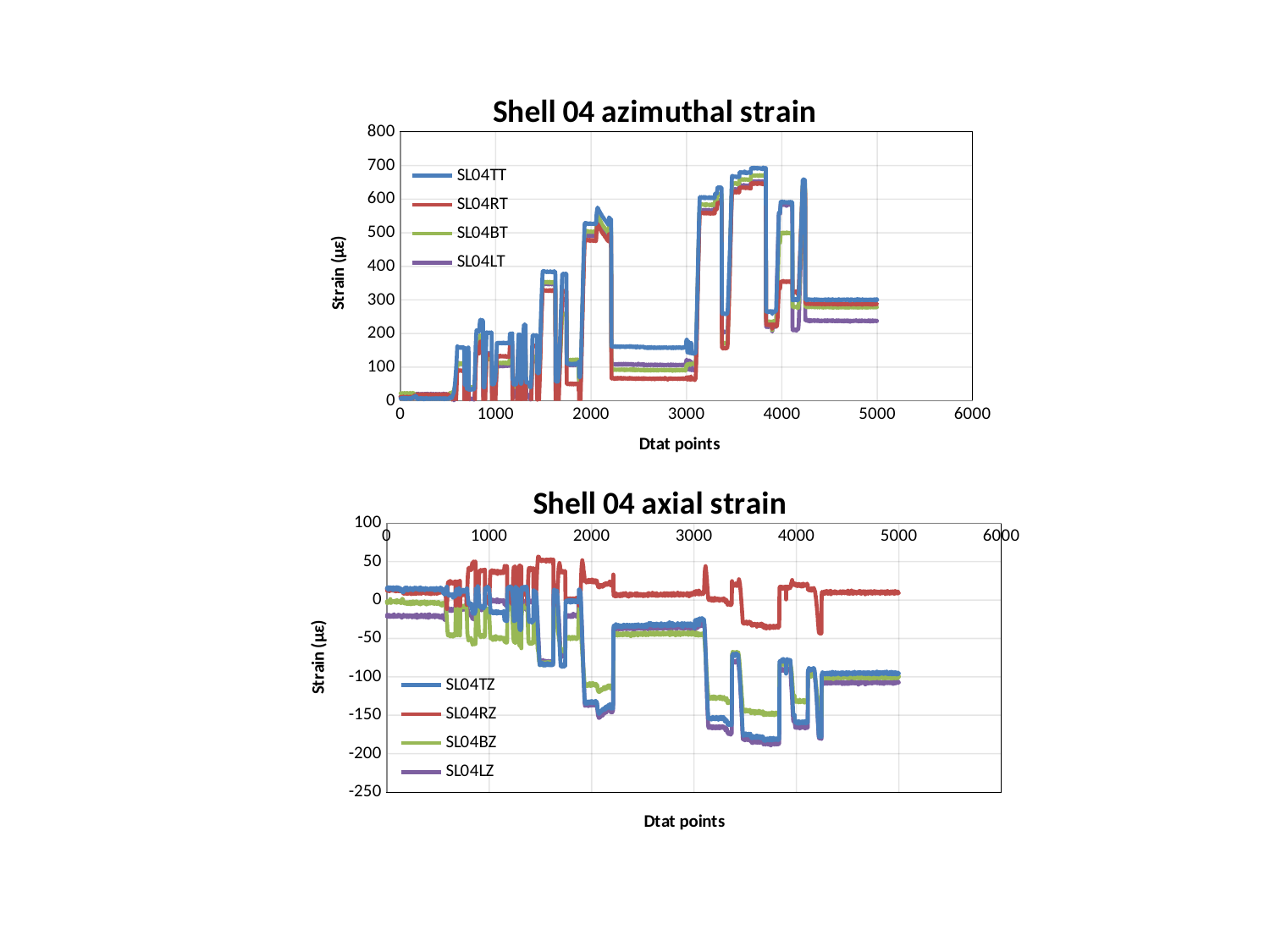
In the 'Shell 04 axial strain' chart, is the value of SL04BZ at around 3500 data points greater or less than -100? less How many series does the legend of the 'Shell 04 axial strain' chart list? 4 What kind of chart is the 'Shell 04 azimuthal strain' chart? line chart What is the y-axis label of the 'Shell 04 axial strain' chart? Strain (με) How many series does the legend of the 'Shell 04 azimuthal strain' chart list? 4 In the 'Shell 04 azimuthal strain' chart, which series is drawn in red? SL04RT In the 'Shell 04 azimuthal strain' chart, at around 5000 data points, which series is higher: SL04TT or SL04LT? SL04TT In the 'Shell 04 axial strain' chart, at around 5000 data points, which series is higher: SL04RZ or SL04TZ? SL04RZ In the 'Shell 04 axial strain' chart, is the value of SL04RZ at around 5000 data points greater or less than -50? greater In the 'Shell 04 azimuthal strain' chart, is the value of SL04LT at around 5000 data points greater or less than 300? less